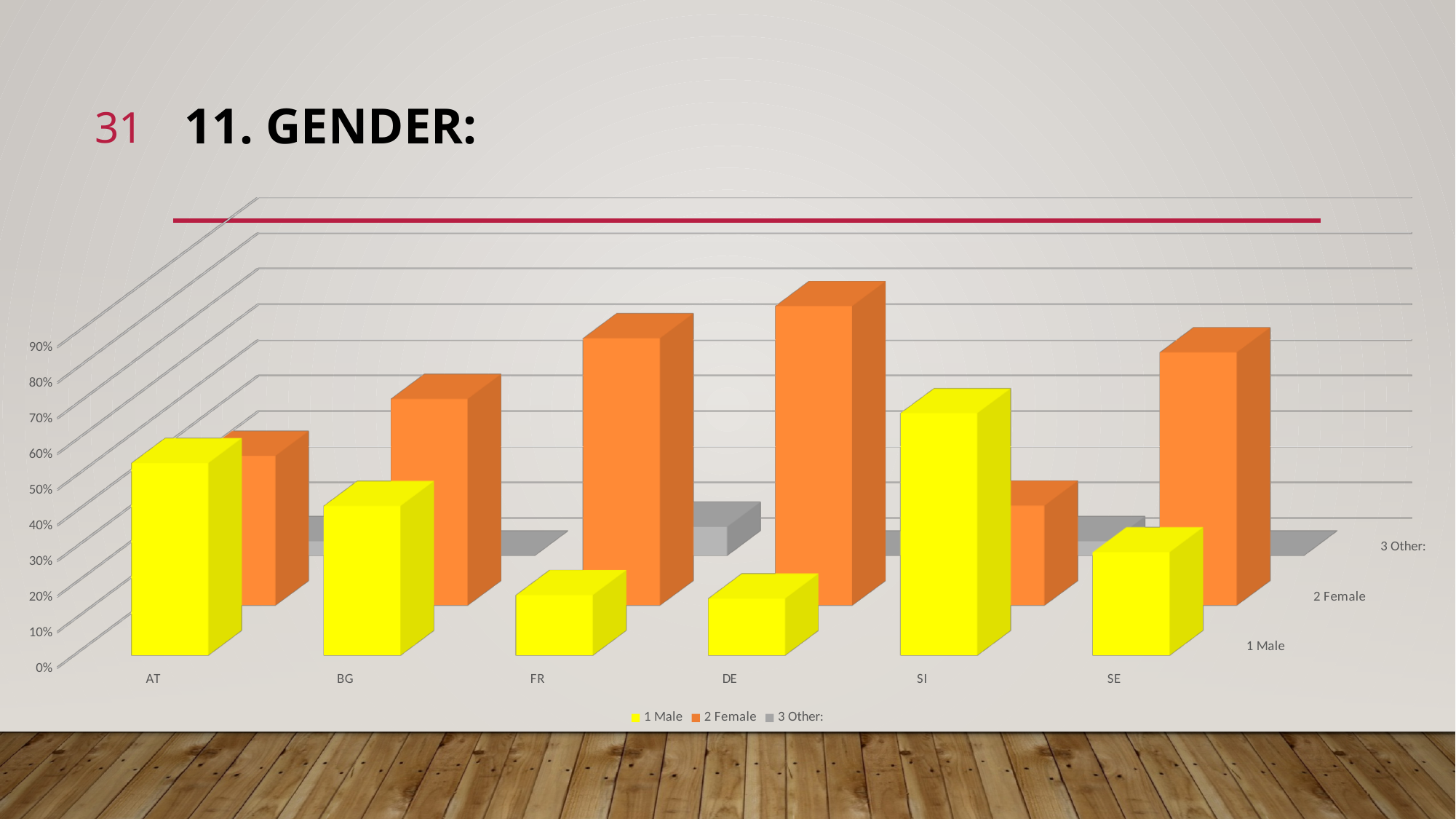
How many countries (categories) are shown on the x axis? 6 How many series does the legend list? 3 What is the title of the slide containing the chart? 11. GENDER: Which country has the highest value for 1 Male? SI What kind of chart is shown on the slide? bar chart Is the 1 Male value for SI greater or less than 50%? greater Which country has the highest value for 2 Female? DE Is the 1 Male value for FR greater or less than 30%? less Which country has the lowest value for 2 Female? SI Is the 2 Female value for DE greater or less than 50%? greater Which is larger, the 1 Male value for AT or for FR? AT In FR, which is larger, the 1 Male value or the 2 Female value? 2 Female